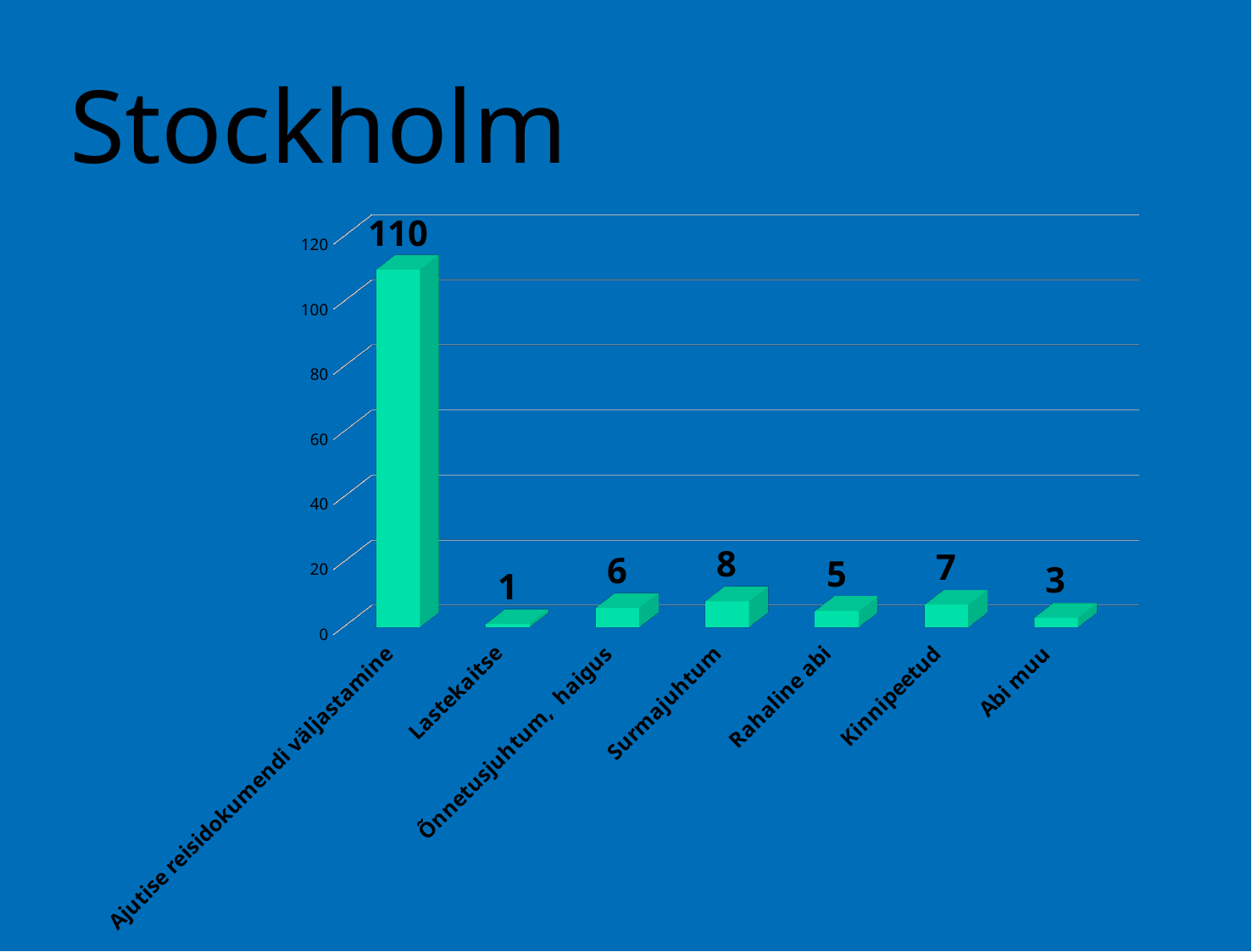
Which category has the lowest value? Lastekaitse What is the value for Lastekaitse? 1 What is the difference between the values for Ajutise reisidokumendi väljastamine and Surmajuhtum? 102 Which is larger, the value for Õnnetusjuhtum, haigus or the value for Rahaline abi? Õnnetusjuhtum, haigus How many categories are shown on the x axis? 7 What is the value for Ajutise reisidokumendi väljastamine? 110 Which category has the highest value? Ajutise reisidokumendi väljastamine What is the value for Surmajuhtum? 8 What is the difference between the values for Kinnipeetud and Abi muu? 4 Is the value for Ajutise reisidokumendi väljastamine greater or less than 100? greater What is the value for Kinnipeetud? 7 What kind of chart is shown on the slide? bar chart